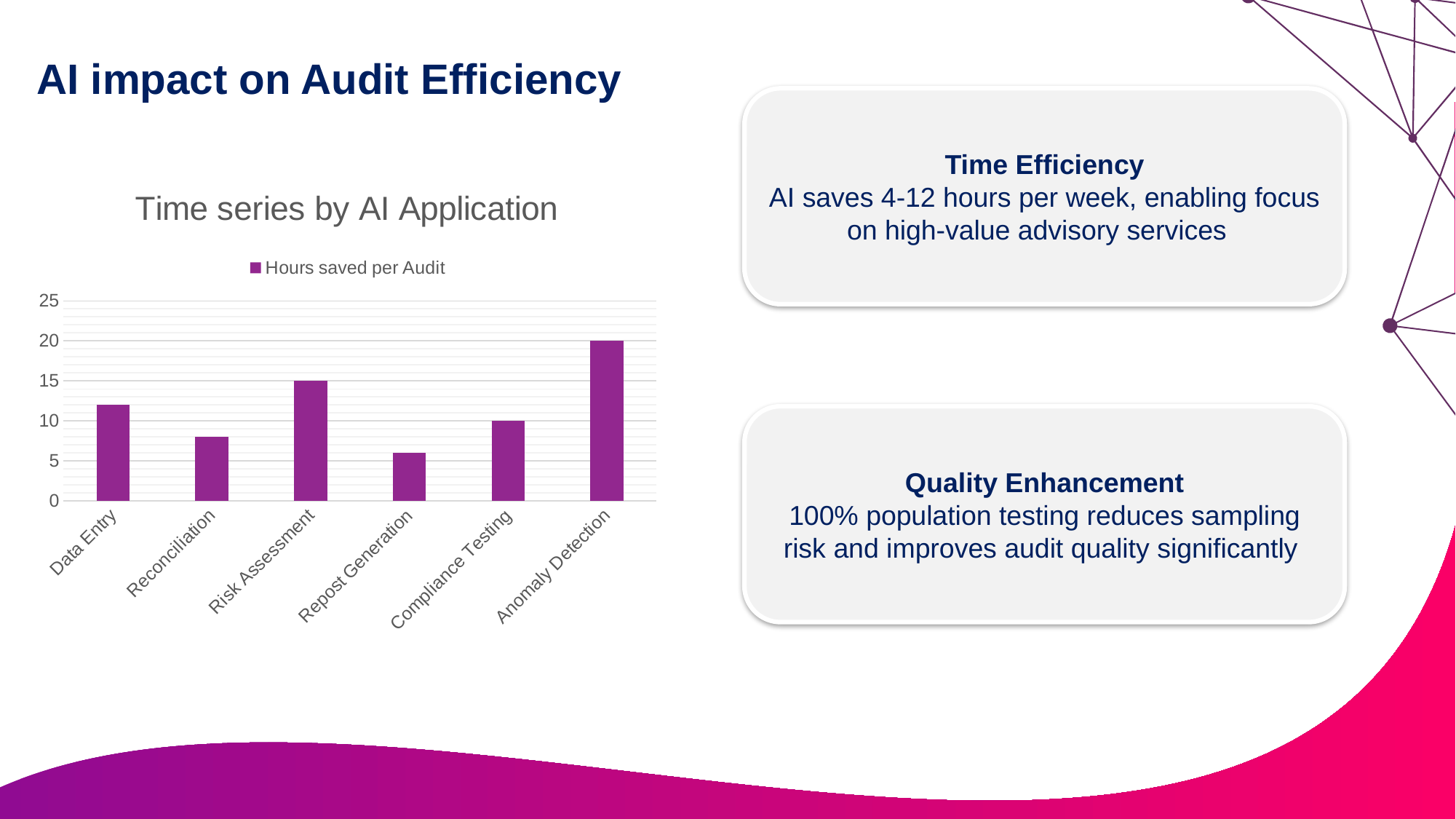
Which has more hours saved per audit, Reconciliation or Risk Assessment? Risk Assessment How many series does the chart legend list? 1 Which AI application has the highest hours saved per audit? Anomaly Detection How many AI application categories are shown on the x axis? 6 Which AI application has the lowest hours saved per audit? Repost Generation How many hours saved per audit are shown for Risk Assessment? 15 How many hours saved per audit are shown for Compliance Testing? 10 How many hours saved per audit are shown for Anomaly Detection? 20 Is the value for Data Entry greater or less than 10? greater What type of chart is shown on the slide? Bar chart What is the difference in hours saved per audit between Anomaly Detection and Risk Assessment? 5 What is the title of the chart? Time series by AI Application